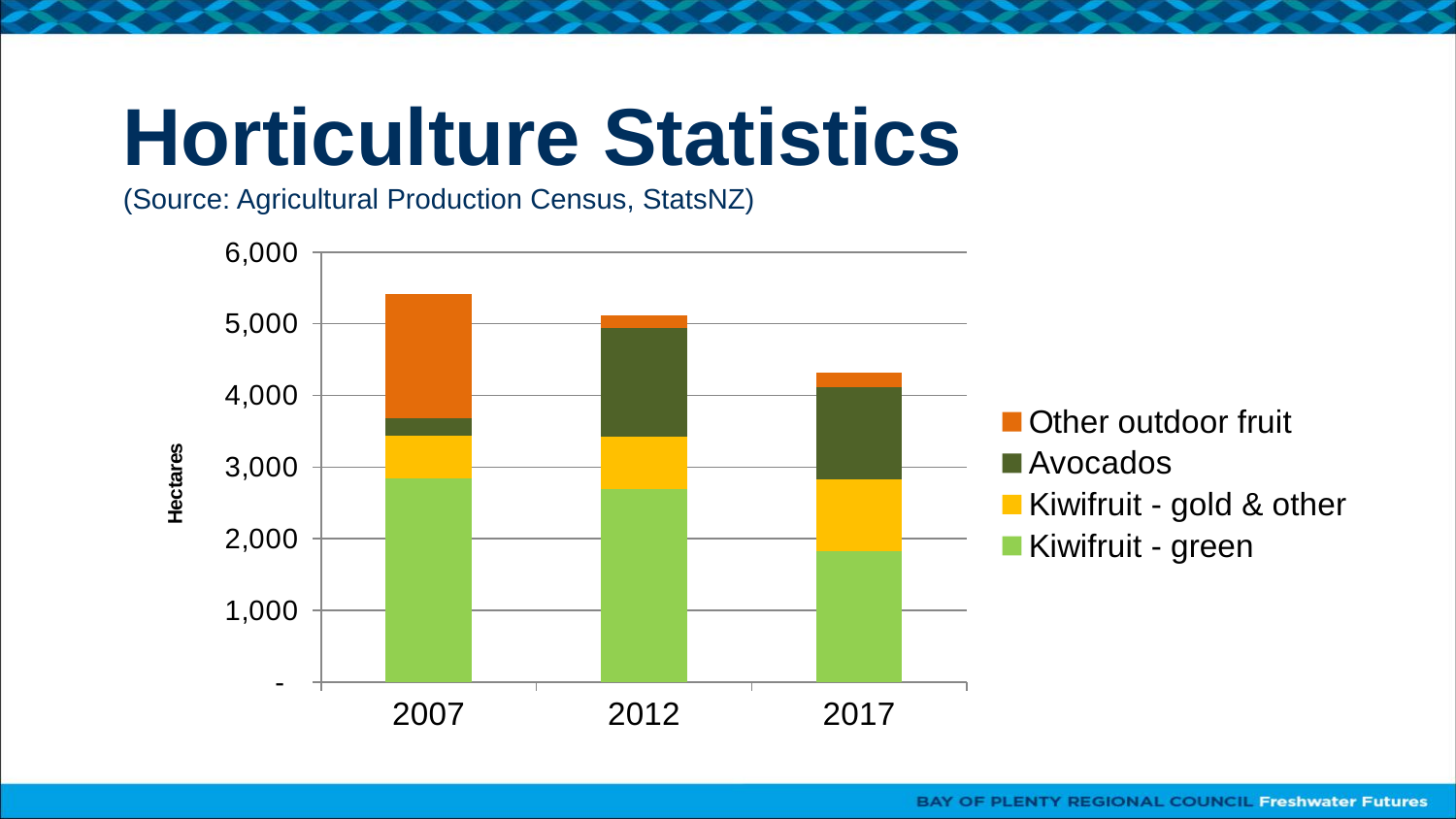
Do the total bar heights rise or fall from 2007 to 2017? fall How many series does the chart's legend list? 4 Is the Kiwifruit - green value for 2017 greater or less than 2,000 hectares? less Which year has the larger Avocados segment, 2007 or 2012? 2012 Is the total height of the 2017 bar greater or less than 5,000 hectares? less Is the total height of the 2007 bar greater or less than 5,000 hectares? greater Which year has the tallest stacked bar in the chart? 2007 Which year has the shortest stacked bar in the chart? 2017 What is the label on the chart's vertical axis? Hectares Which year has the larger Kiwifruit - green segment, 2007 or 2017? 2007 How many years are shown on the x axis of the chart? 3 What kind of chart is shown on the slide? Stacked bar chart